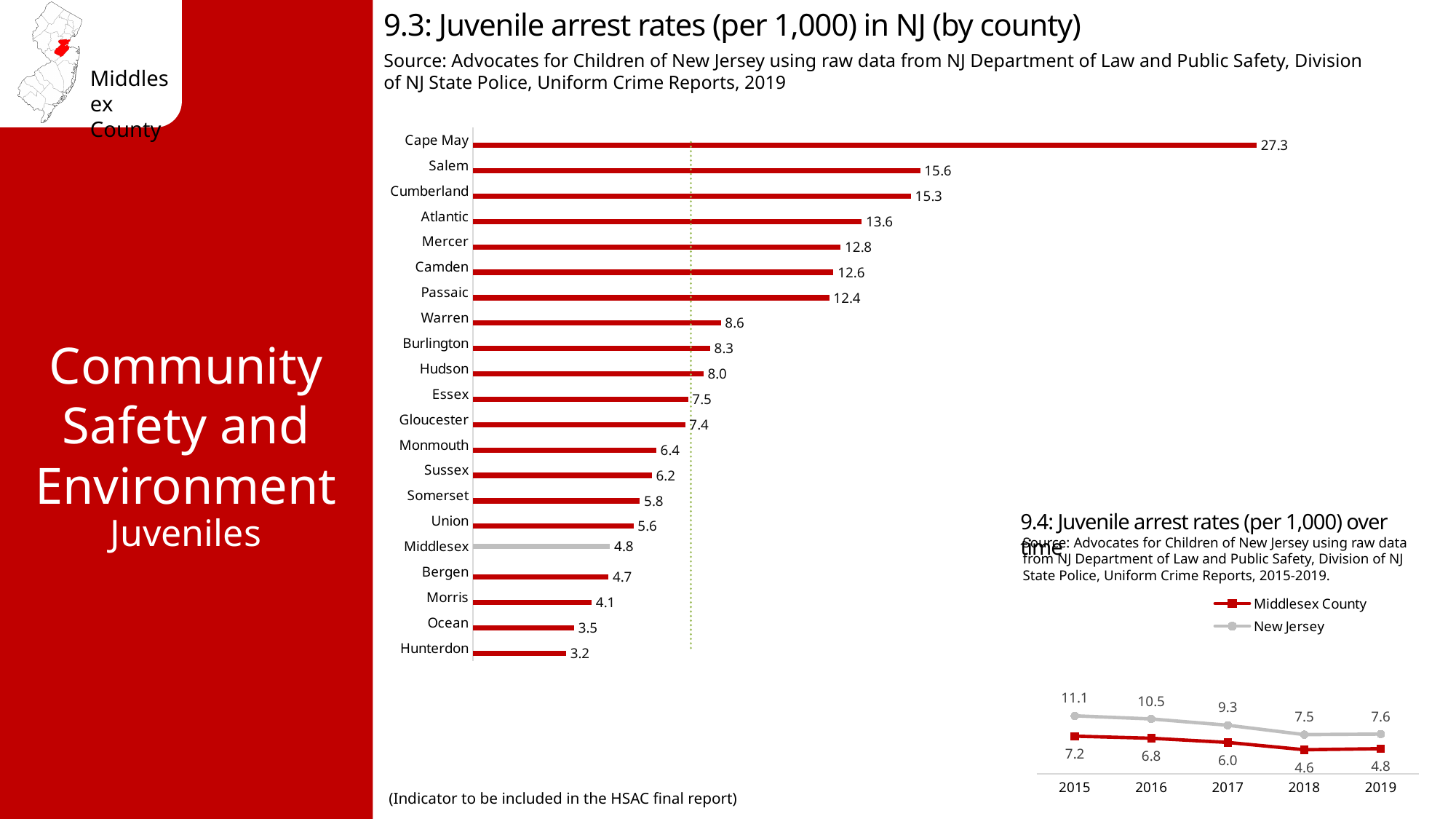
In chart 9.3 (juvenile arrest rates by county), how many counties are shown? 21 In chart 9.3 (juvenile arrest rates by county), what is the difference between the rates for Cape May and Salem? 11.7 In chart 9.3 (juvenile arrest rates by county), which county has a higher rate, Mercer or Passaic? Mercer In chart 9.3 (juvenile arrest rates by county), what is the juvenile arrest rate for Middlesex? 4.8 In chart 9.4 (juvenile arrest rates over time), did the Middlesex County rate rise or fall from 2015 to 2018? Fall In chart 9.4 (juvenile arrest rates over time), what is the difference between the New Jersey and Middlesex County rates in 2015? 3.9 In chart 9.3 (juvenile arrest rates by county), which county has the lowest juvenile arrest rate? Hunterdon What kind of chart is chart 9.3 (juvenile arrest rates by county)? Bar chart In chart 9.4 (juvenile arrest rates over time), what was the New Jersey rate in 2017? 9.3 In chart 9.4 (juvenile arrest rates over time), how many series does the legend list? 2 In chart 9.3 (juvenile arrest rates by county), which county has the highest juvenile arrest rate? Cape May In chart 9.3 (juvenile arrest rates by county), what is the juvenile arrest rate for Hudson? 8.0